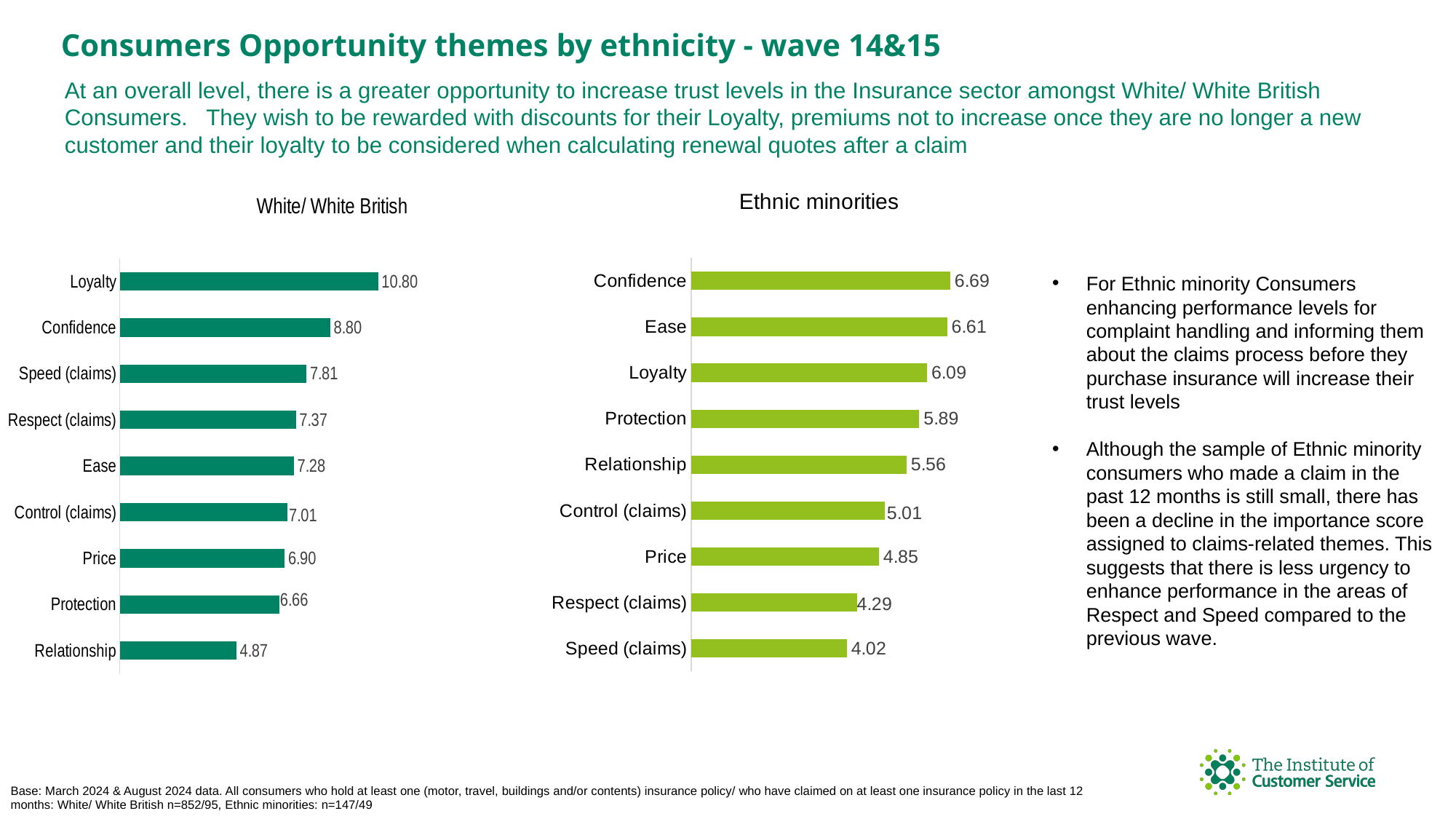
How many categories are shown in the White/ White British chart? 9 In the White/ White British chart, what is the difference between Loyalty and Confidence? 2.00 In the White/ White British chart, which category has the lowest value? Relationship In the White/ White British chart, what is the value for Speed (claims)? 7.81 In the White/ White British chart, which is larger, Price or Protection? Price In the White/ White British chart, what is the value for Loyalty? 10.80 What type of chart is the Ethnic minorities chart? Bar chart In the Ethnic minorities chart, what is the value for Confidence? 6.69 In the Ethnic minorities chart, which category has the highest value? Confidence In the Ethnic minorities chart, which category has the lowest value? Speed (claims) In the Ethnic minorities chart, what is the difference between Loyalty and Protection? 0.20 In the Ethnic minorities chart, which is larger, Relationship or Control (claims)? Relationship